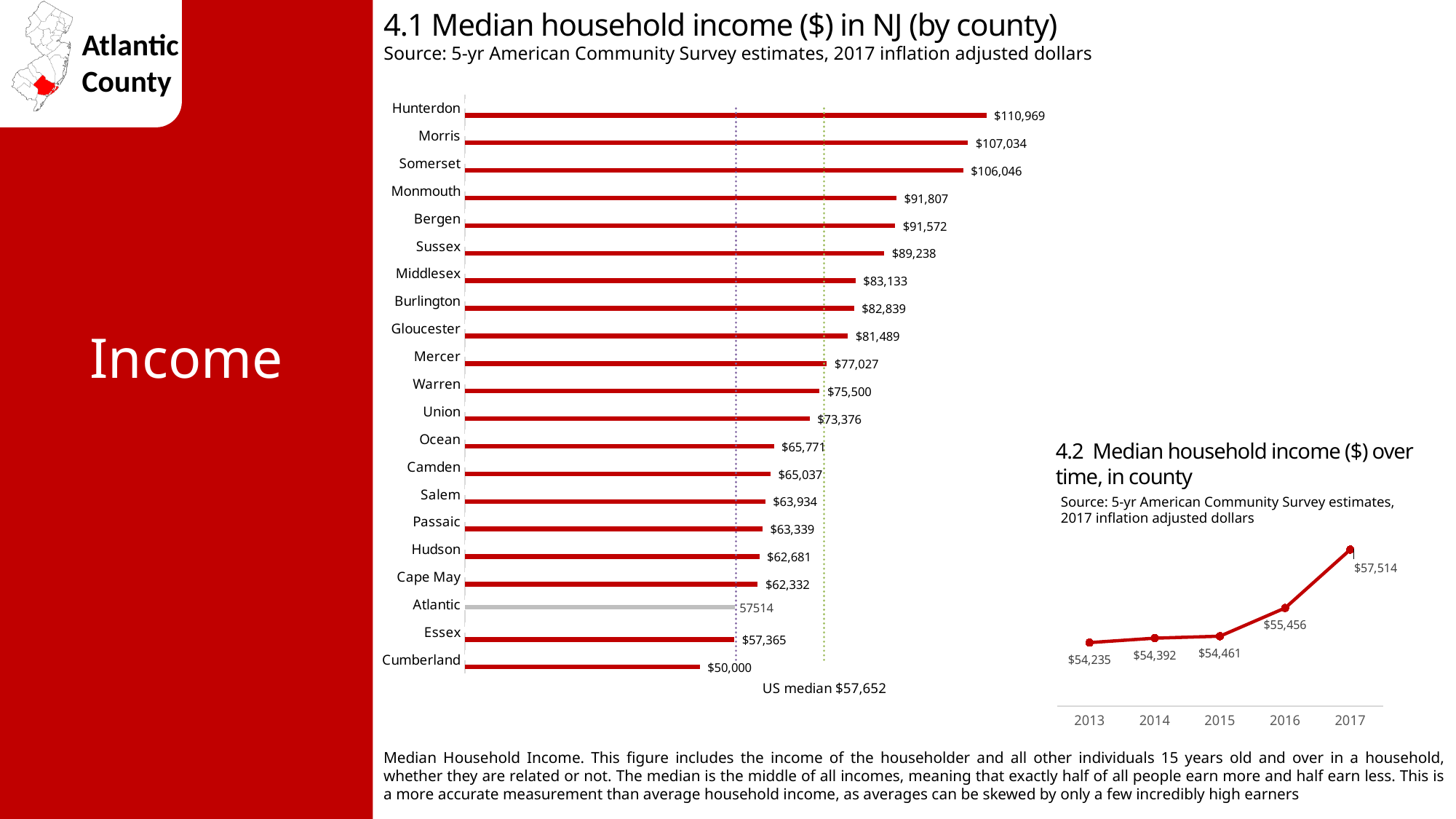
In chart 4.2, what is the difference between the 2017 and 2013 values? $3,279 In chart 4.2, does the median household income rise or fall from 2013 to 2017? Rise In chart 4.1 (Median household income in NJ by county), what is the median household income for Hunterdon? $110,969 In chart 4.1, what US median value is noted below the chart? $57,652 In chart 4.1, which county has the lowest median household income? Cumberland In chart 4.2 (Median household income over time, in county), what is the value for 2016? $55,456 In chart 4.1, how many counties are shown? 21 In chart 4.1, which county has the highest median household income? Hunterdon What kind of chart is chart 4.1? Bar chart In chart 4.1, what is the difference between the median household income of Hunterdon and Cumberland? $60,969 In chart 4.1, what is the median household income for Cape May? $62,332 In chart 4.1, which county has a higher median household income, Mercer or Ocean? Mercer